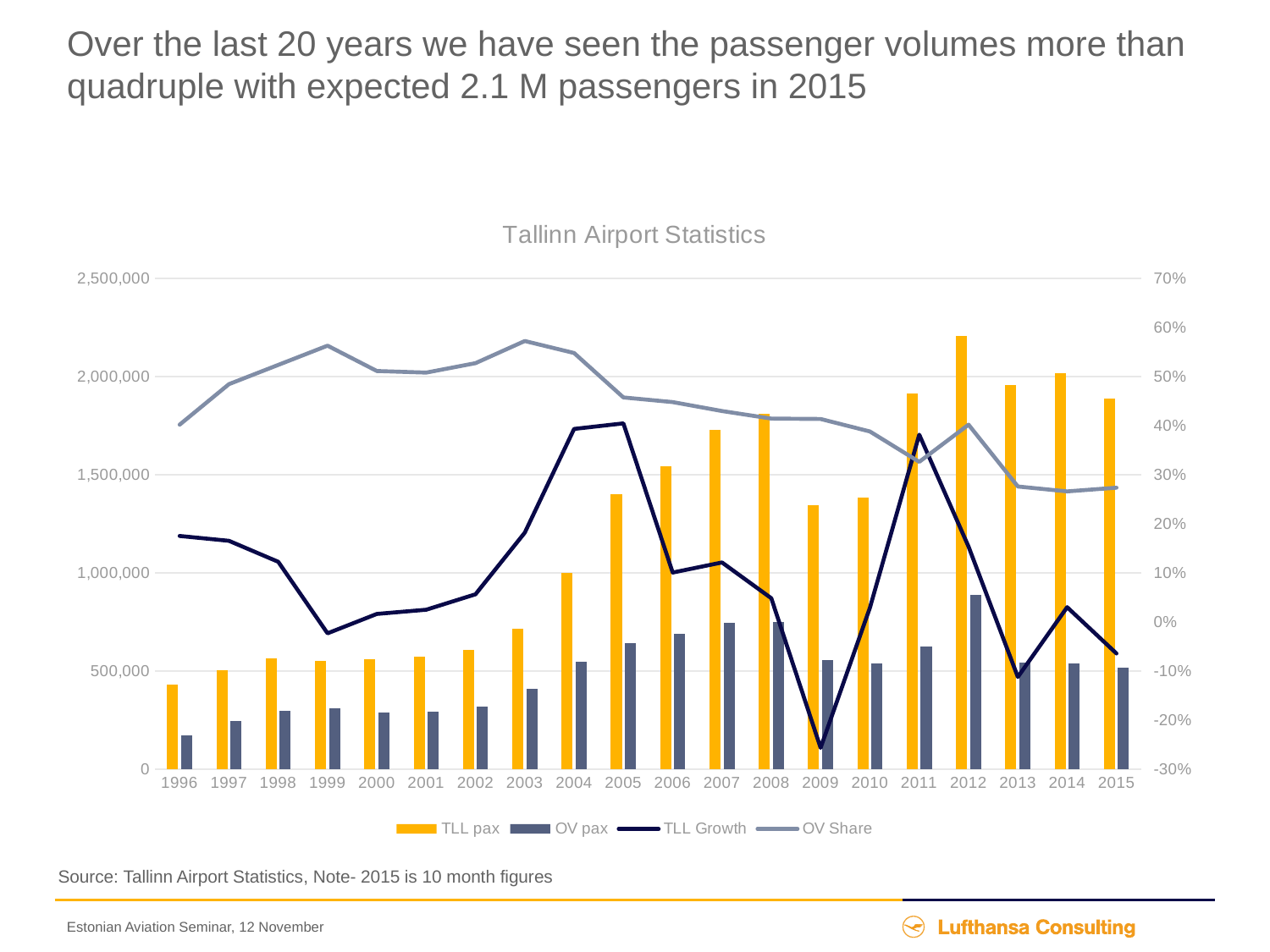
How many years are shown on the x axis? 20 Is the OV Share value for 2003 greater or less than 50%? greater Is the TLL pax value for 2012 greater or less than 2,000,000? greater Is the TLL Growth value for 2009 greater or less than -20%? less Which year has the lowest TLL pax bar? 1996 What is the title of the chart? Tallinn Airport Statistics How many series does the legend list? 4 Which year has the highest OV pax bar? 2012 Which year has the larger TLL pax bar, 2010 or 2011? 2011 Which year has the highest TLL pax bar? 2012 In which year does the TLL Growth line reach its lowest point? 2009 What kind of chart is shown on the slide? Combination bar and line chart